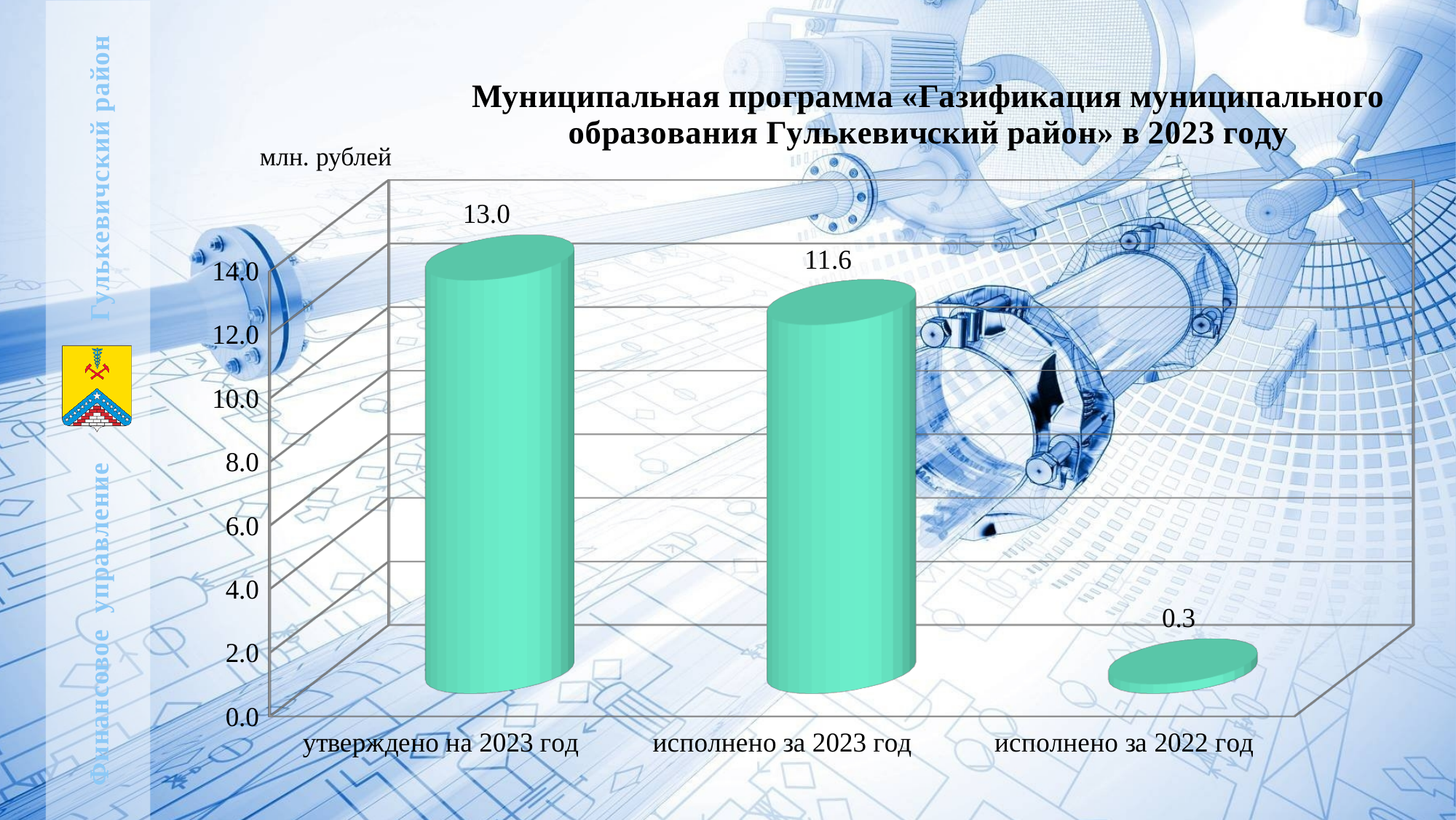
Which category has the highest value? утверждено на 2023 год What kind of chart is shown on the slide? bar chart Which category has the lowest value? исполнено за 2022 год What unit is indicated above the vertical axis of the chart? млн. рублей Is the value for «исполнено за 2023 год» greater or less than 10.0? greater What is the value for «исполнено за 2023 год»? 11.6 How many categories are shown on the chart? 3 What is the difference between «исполнено за 2023 год» and «исполнено за 2022 год»? 11.3 What is the value for «исполнено за 2022 год»? 0.3 What is the value for «утверждено на 2023 год»? 13.0 What is the difference between «утверждено на 2023 год» and «исполнено за 2023 год»? 1.4 Which is larger: «исполнено за 2023 год» or «исполнено за 2022 год»? исполнено за 2023 год